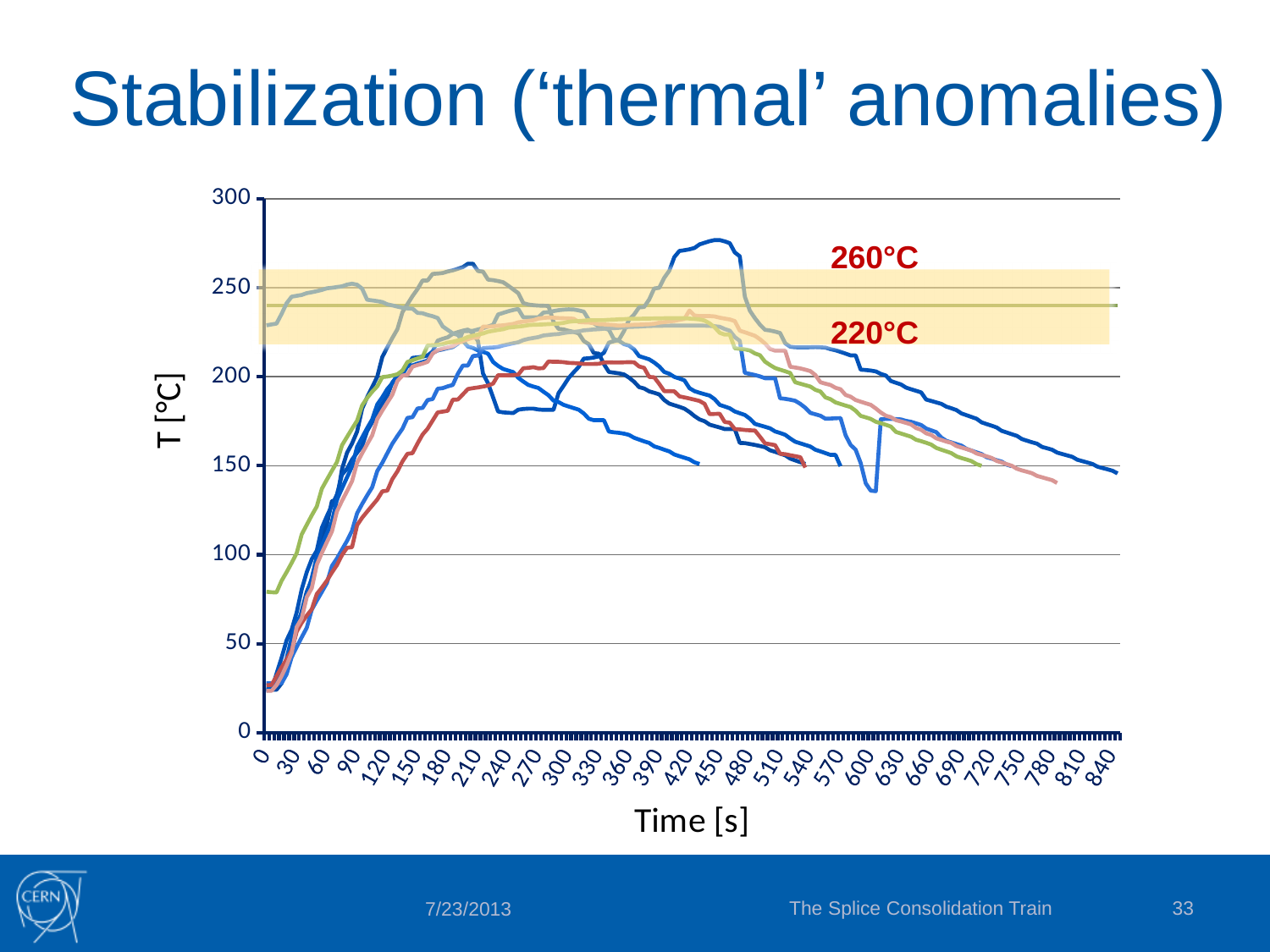
Does the dark blue curve that extends to 840 s rise or fall between 600 s and 840 s? fall Is the highest peak reached by any curve in the chart greater or less than 250? greater What is the highest value shown on the vertical axis of the chart? 300 Do the curves in the chart generally rise or fall between time 0 and time 120? rise What is the last time value labelled on the horizontal axis of the chart? 840 What is the label of the horizontal axis of the chart? Time [s] What upper temperature is annotated on the shaded band in the chart? 260°C What lower temperature is annotated on the shaded band in the chart? 220°C What is the label of the vertical axis of the chart? T [°C] Is the value of the red curve at time 0 greater or less than 50? less What kind of chart is shown on the slide? line chart Is the value of the green curve at time 0 greater or less than 50? greater